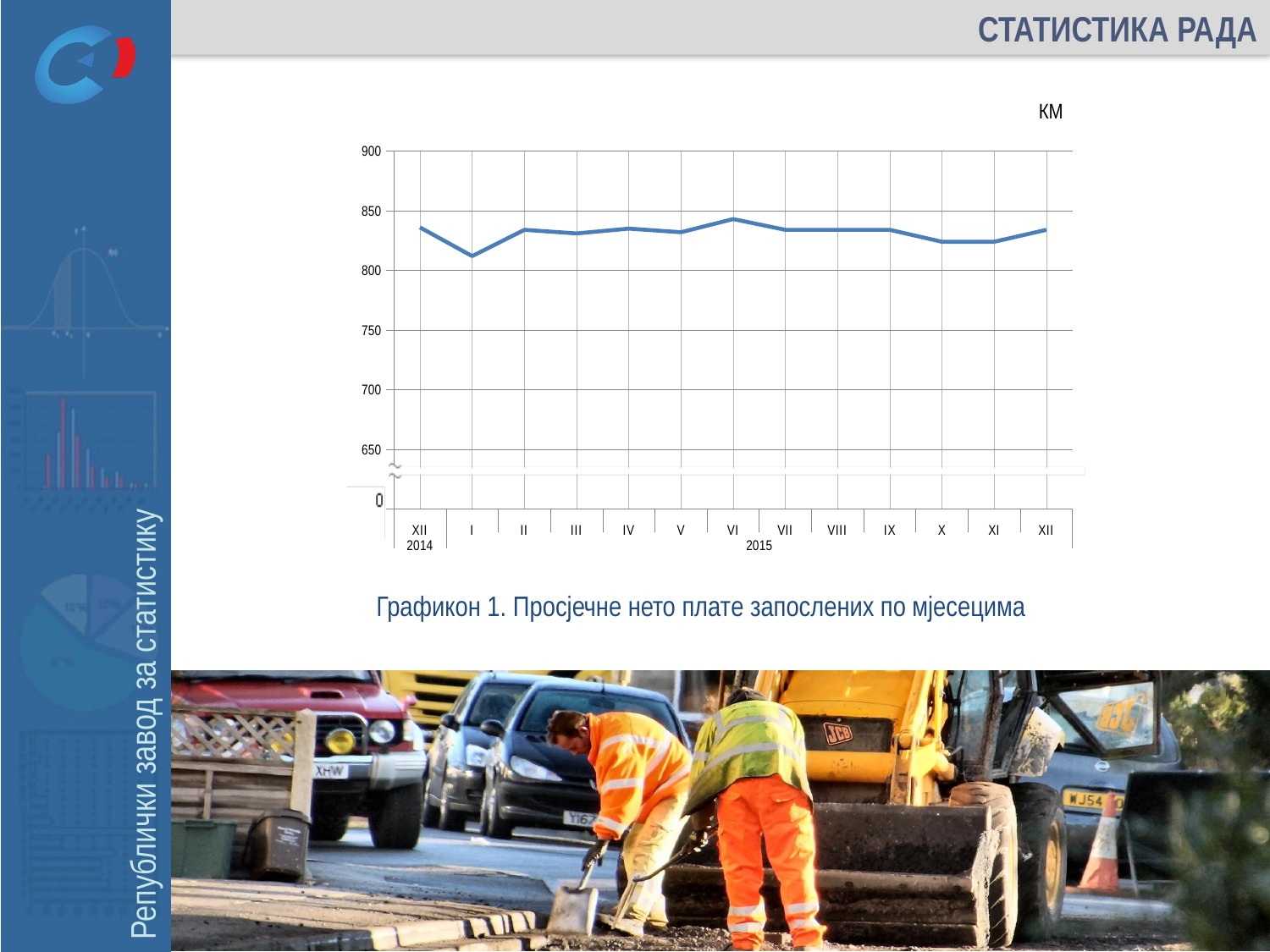
Which month has the highest average net wage on the chart? VI 2015 Which month has the lowest average net wage on the chart? I 2015 What is the title of the chart on the slide? Графикон 1. Просјечне нето плате запослених по мјесецима Is the value for XII 2014 greater or less than 750? greater What kind of chart is shown on the slide? line chart Which is larger, the value for XII 2014 or the value for I 2015? XII 2014 How many monthly points are plotted on the chart? 13 Does the line rise or fall from XII 2014 to I 2015? fall Is the value for I 2015 greater or less than 850? less Is the value for VI 2015 greater or less than 800? greater What unit is shown above the chart's y axis? KM Which is larger, the value for I 2015 or the value for VI 2015? VI 2015